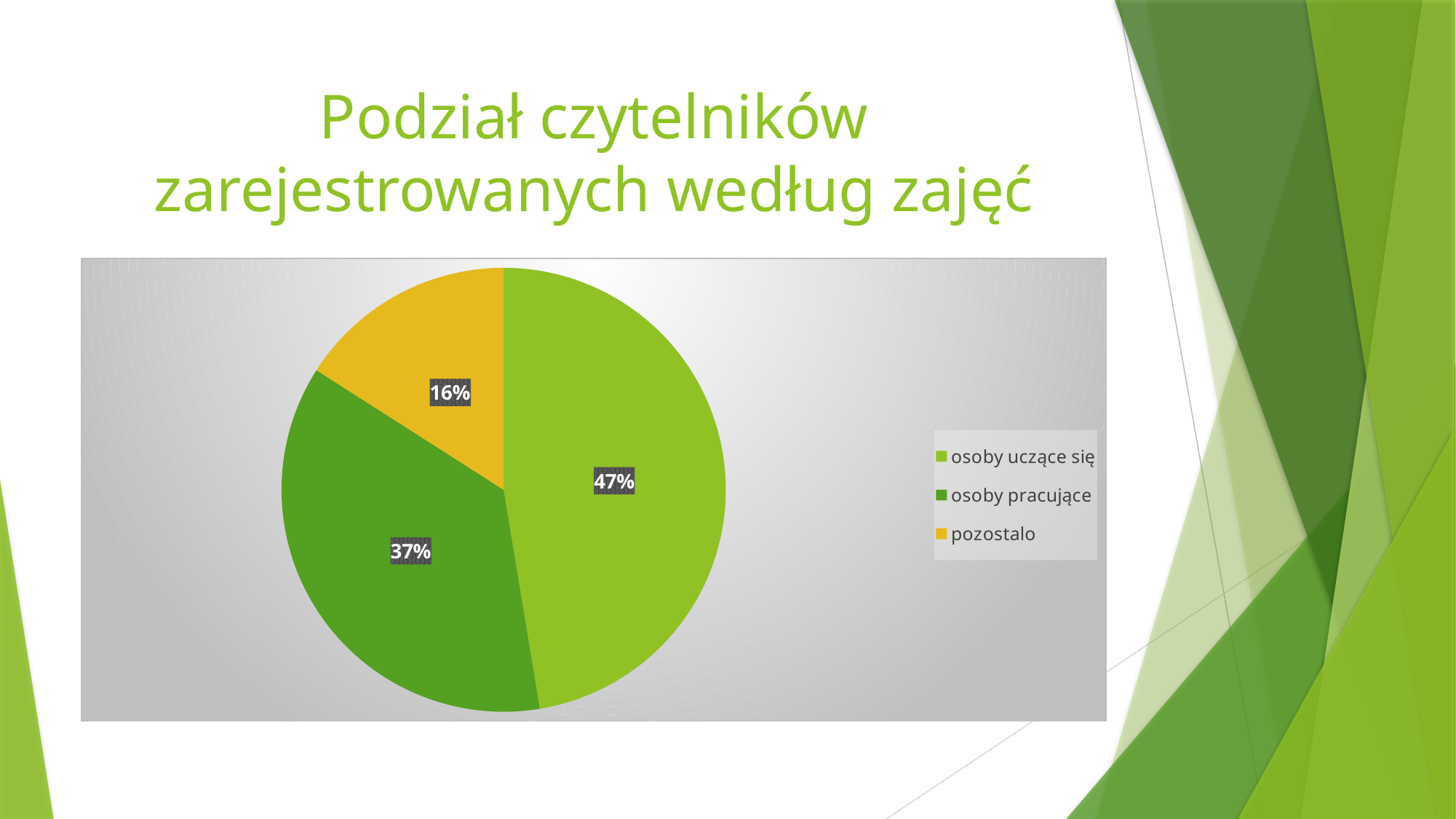
What is the title of the slide containing the chart? Podział czytelników zarejestrowanych według zajęć What share of the pie is labelled for "pozostalo"? 16% What kind of chart is shown on the slide? pie chart Which slice is larger: "osoby pracujące" or "pozostalo"? osoby pracujące Which category is shown in yellow in the legend? pozostalo What share of the pie is labelled for "osoby uczące się"? 47% How many slices does the pie chart have? 3 Which category has the largest slice of the pie? osoby uczące się What is the difference in percentage points between the "osoby pracujące" slice and the "pozostalo" slice? 21 Which category has the smallest slice of the pie? pozostalo What is the difference in percentage points between the "osoby uczące się" slice and the "osoby pracujące" slice? 10 What share of the pie is labelled for "osoby pracujące"? 37%